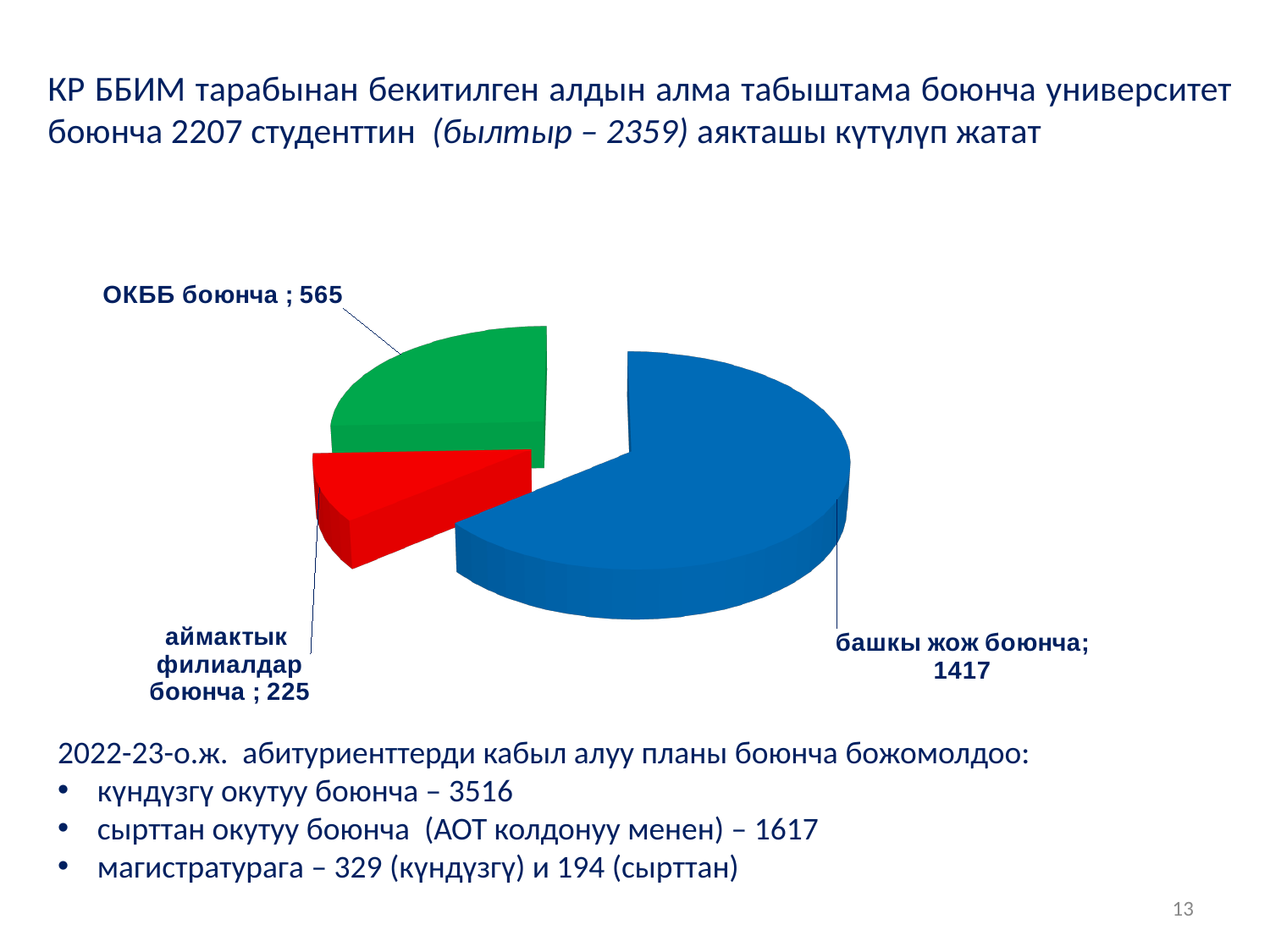
What is the difference between the values for "ОКББ боюнча" and "аймактык филиалдар боюнча"? 340 What kind of chart is shown on the slide? pie chart What colour is the slice for "аймактык филиалдар боюнча"? red What is the difference between the values for "башкы жож боюнча" and "ОКББ боюнча"? 852 How many slices does the pie chart have? 3 Which is larger: the value for "ОКББ боюнча" or the value for "аймактык филиалдар боюнча"? ОКББ боюнча What is the value for "башкы жож боюнча" in the pie chart? 1417 What is the value for "аймактык филиалдар боюнча" in the pie chart? 225 What is the total of all three slices in the pie chart? 2207 What is the value for "ОКББ боюнча" in the pie chart? 565 Which category has the largest slice in the pie chart? башкы жож боюнча Which category has the smallest slice in the pie chart? аймактык филиалдар боюнча